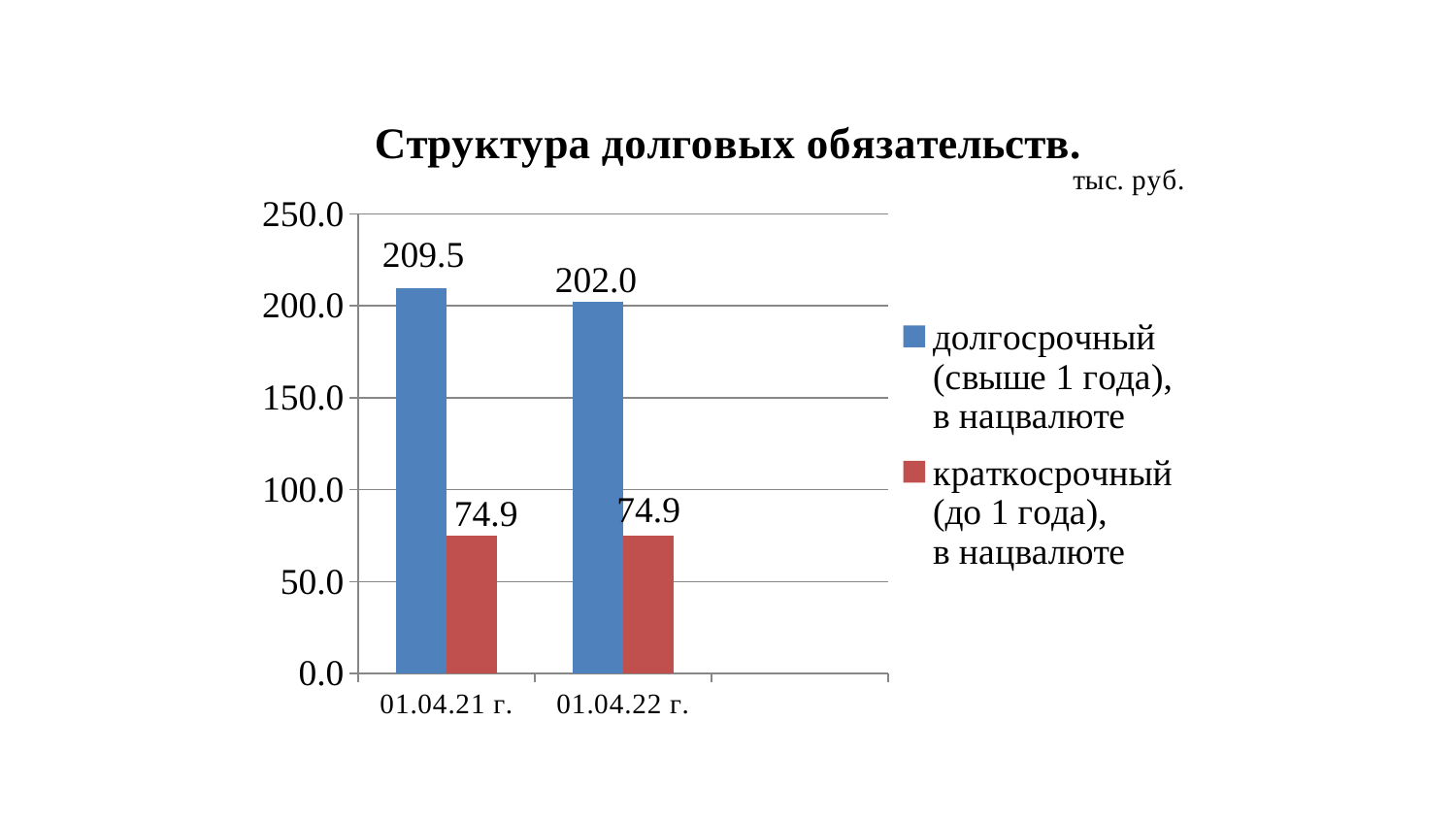
What is the value of долгосрочный (свыше 1 года), в нацвалюте for 01.04.22 г.? 202.0 How many dates are shown on the x axis? 2 What type of chart is shown? bar chart What is the difference between the долгосрочный and краткосрочный values for 01.04.22 г.? 127.1 Which is larger for 01.04.21 г.: долгосрочный or краткосрочный? долгосрочный What is the value of краткосрочный (до 1 года), в нацвалюте for 01.04.22 г.? 74.9 What is the value of краткосрочный (до 1 года), в нацвалюте for 01.04.21 г.? 74.9 Does the долгосрочный value for 01.04.22 г. rise or fall compared with 01.04.21 г.? fall How many series does the legend list? 2 What is the value of долгосрочный (свыше 1 года), в нацвалюте for 01.04.21 г.? 209.5 What is the difference between the долгосрочный values for 01.04.21 г. and 01.04.22 г.? 7.5 Which date has the higher value for долгосрочный (свыше 1 года), в нацвалюте? 01.04.21 г.